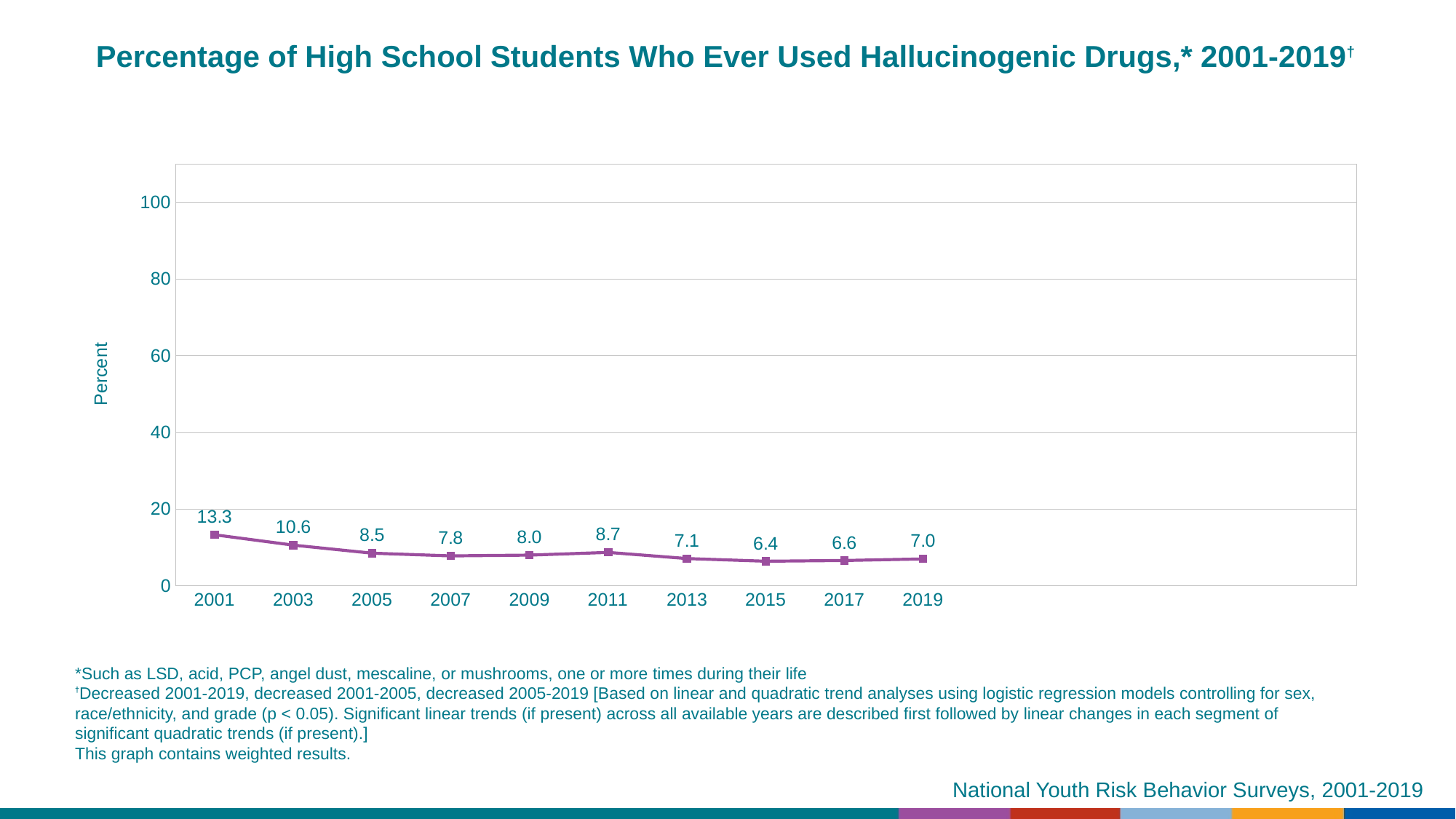
What is the value plotted for 2019? 7.0 Which year has the lowest percentage? 2015 What is the label on the y axis? Percent What is the difference between the 2003 value and the 2005 value? 2.1 Which year has a larger value, 2009 or 2013? 2009 What is the difference between the 2001 value and the 2019 value? 6.3 What percentage of high school students had ever used hallucinogenic drugs in 2001? 13.3 What kind of chart is shown on the slide? line chart How many years are plotted on the chart? 10 Which year has the highest percentage? 2001 Is the value for 2001 greater or less than 20? less What is the value plotted for 2011? 8.7